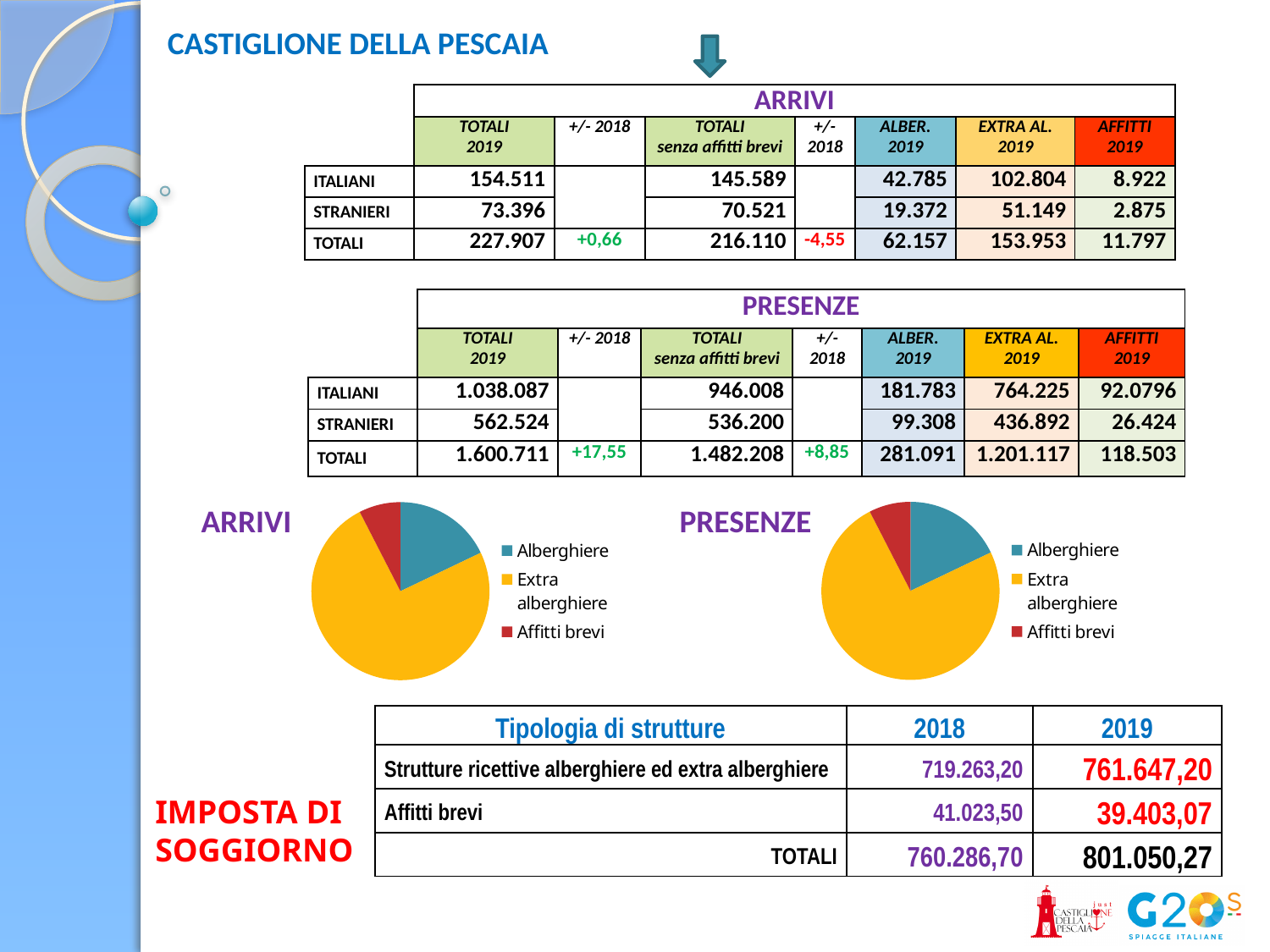
In the ARRIVI pie chart, which slice is larger: Alberghiere or Affitti brevi? Alberghiere In the PRESENZE pie chart, which category has the largest slice? Extra alberghiere In the ARRIVI pie chart, which category has the smallest slice? Affitti brevi What kind of chart is the PRESENZE chart? pie chart In the PRESENZE pie chart, what colour is the Affitti brevi slice? red What kind of chart is the ARRIVI chart? pie chart How many slices does the ARRIVI pie chart have? 3 In the PRESENZE pie chart, which category has the smallest slice? Affitti brevi How many entries does the legend of the PRESENZE pie chart list? 3 In the ARRIVI pie chart, which category has the largest slice? Extra alberghiere In the ARRIVI pie chart, what colour is the Extra alberghiere slice? yellow In the PRESENZE pie chart, which slice is larger: Extra alberghiere or Alberghiere? Extra alberghiere